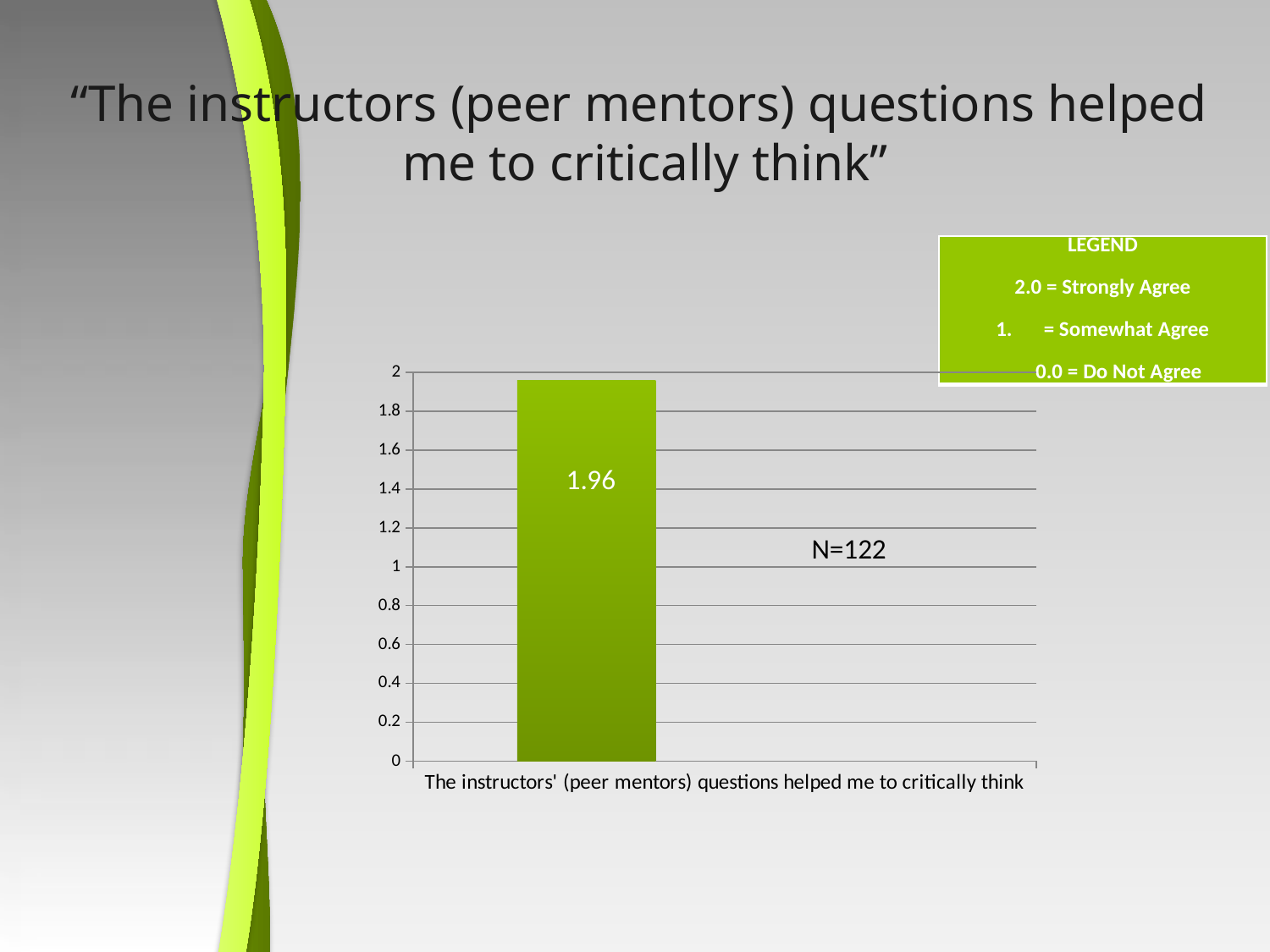
What is the value shown for "The instructors' (peer mentors) questions helped me to critically think"? 1.96 Is the value for "The instructors' (peer mentors) questions helped me to critically think" greater or less than 1? greater How many bars are plotted in the chart? 1 What kind of chart is shown on the slide? bar chart According to the legend, what does a value of 2.0 mean? Strongly Agree Is the value for "The instructors' (peer mentors) questions helped me to critically think" greater or less than 1.8? greater What is the maximum value shown on the vertical axis? 2 What is the sample size (N) shown on the chart? N=122 What is the category label on the horizontal axis? The instructors' (peer mentors) questions helped me to critically think